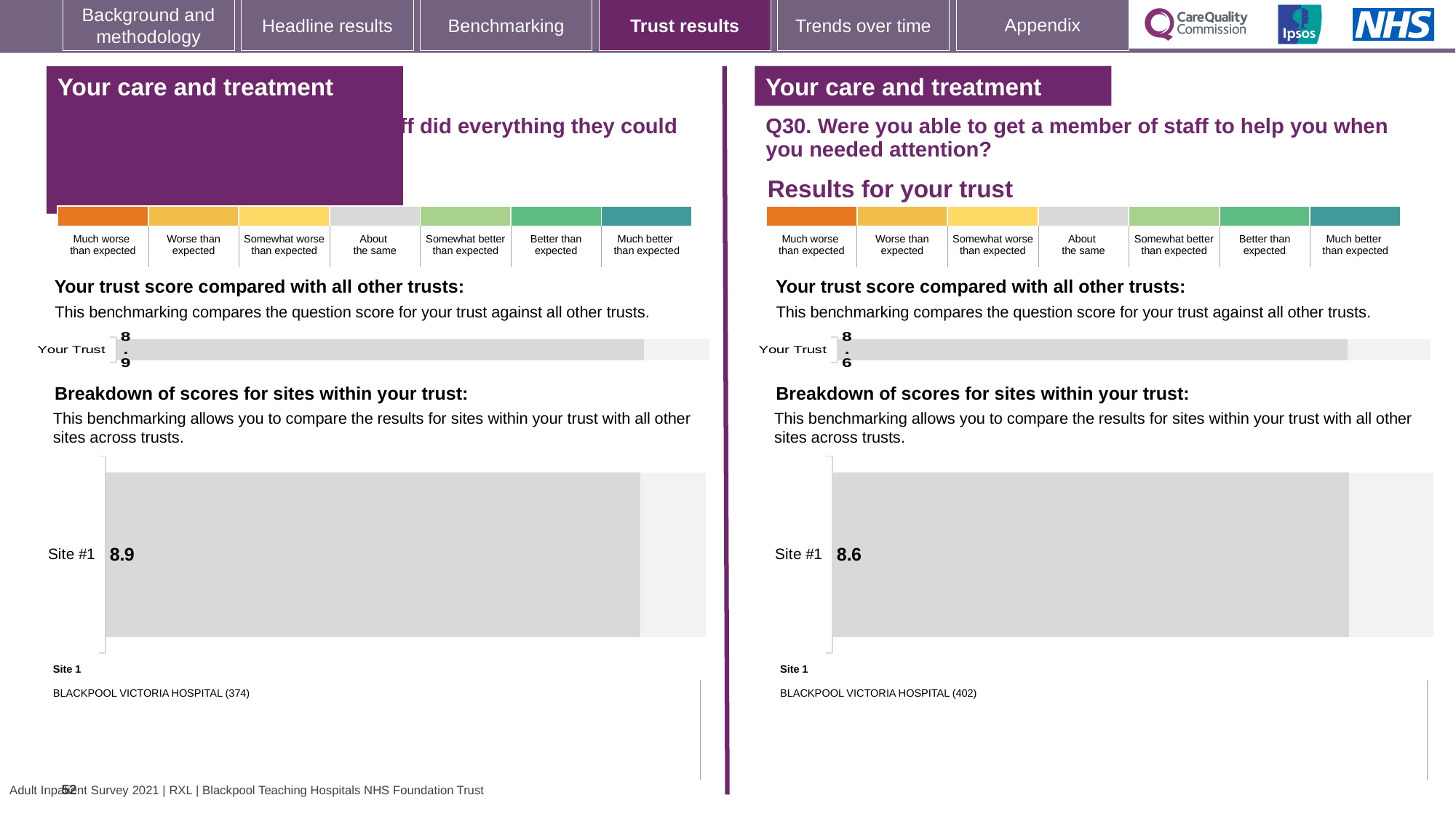
In the left-hand breakdown of scores for sites chart, what is the value for Site #1? 8.9 Which is larger: the Your Trust score on the left half of the slide or the Your Trust score on the right half (Q30)? Left half (8.9) How many sites are shown in the left-hand breakdown of scores for sites chart? 1 Which site is listed as Site 1 on the right half of the slide (Q30)? BLACKPOOL VICTORIA HOSPITAL (402) How many sites are shown in the right-hand breakdown of scores for sites chart (Q30)? 1 Which site is listed as Site 1 on the left half of the slide? BLACKPOOL VICTORIA HOSPITAL (374) What is the difference between the Site #1 score on the left half of the slide and the Site #1 score on the right half (Q30)? 0.3 In the right-hand breakdown of scores for sites chart (Q30), what is the value for Site #1? 8.6 What kind of chart is used to show the Site #1 score on the right half of the slide? Bar chart On the left half of the slide, what is the score shown for Your Trust? 8.9 Is the Site #1 score on the right half of the slide (Q30) greater or less than the Site #1 score on the left half? less On the right half of the slide (Q30), what is the score shown for Your Trust? 8.6